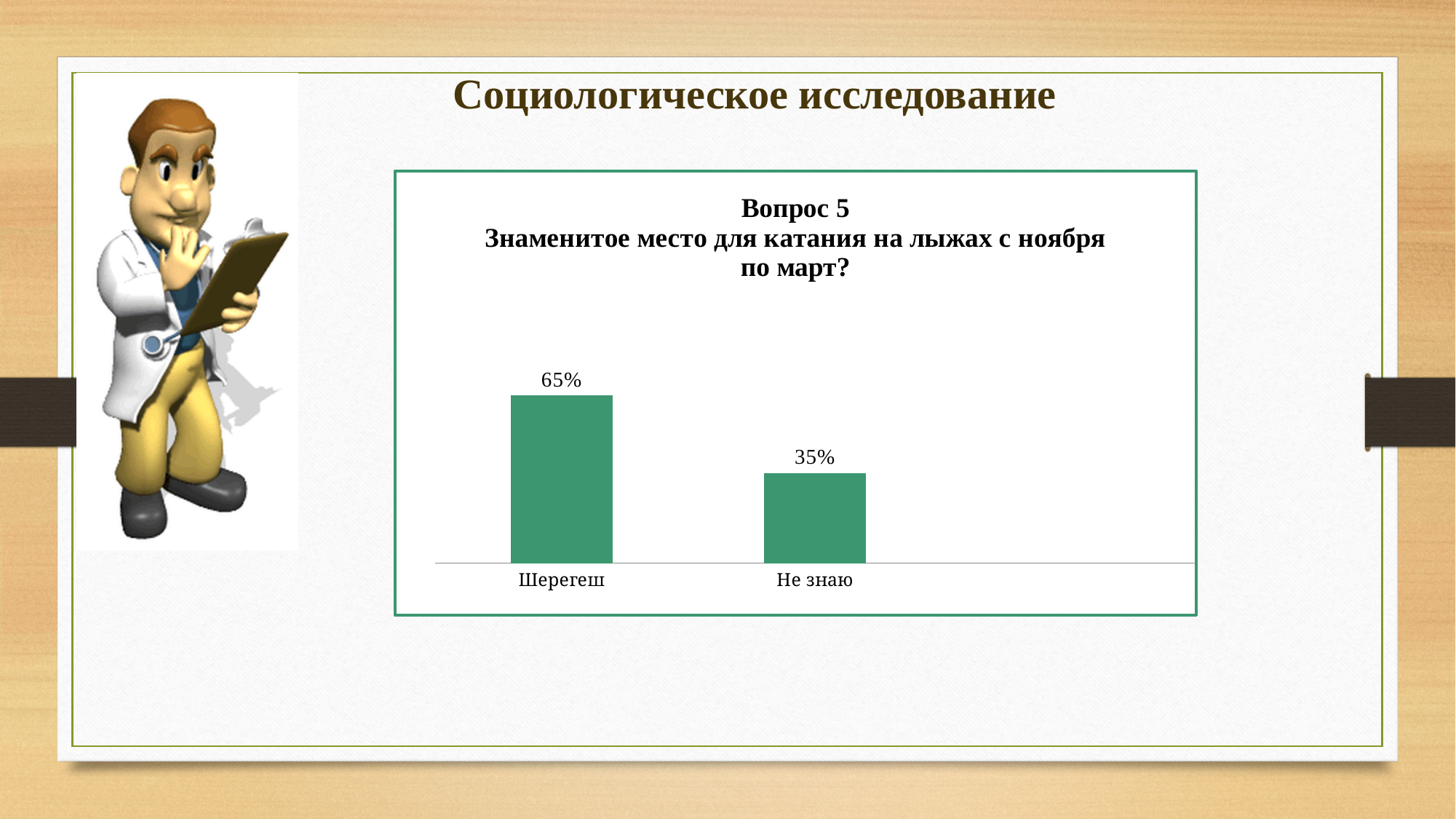
What is the value for Не знаю? 35% What is the difference between the values for Шерегеш and Не знаю? 30% What is the value for Шерегеш? 65% Do the values rise or fall from left to right along the x axis? Fall What is the total of the two values shown in the chart? 100% What colour are the bars in the chart? Green Which category has the lowest value? Не знаю How many categories are shown in the chart? 2 What question number is given in the chart title? Вопрос 5 What kind of chart is shown on the slide? Bar chart Which is larger, the value for Шерегеш or the value for Не знаю? Шерегеш Which category has the highest value? Шерегеш